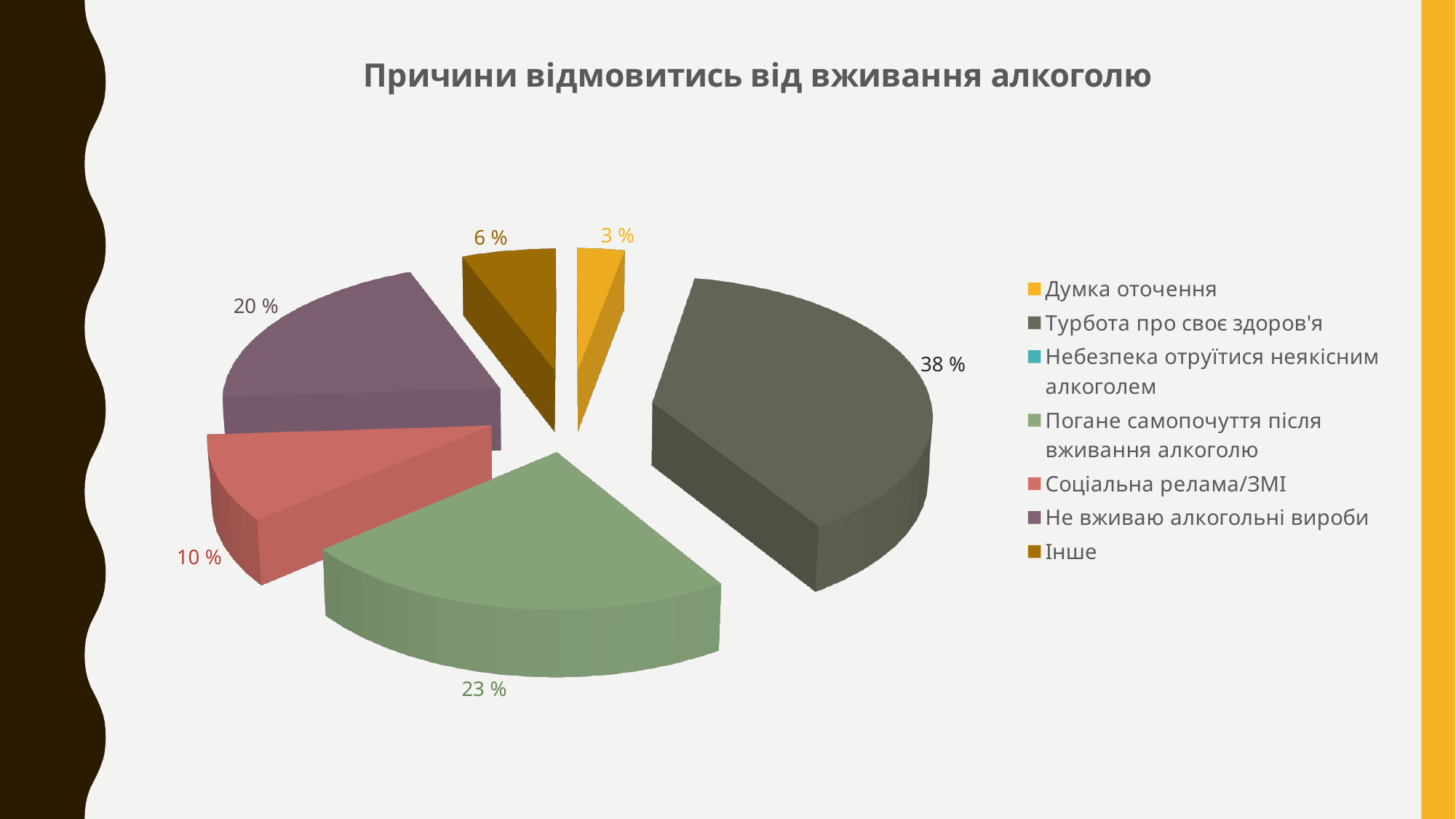
What percentage is shown for "Турбота про своє здоров'я"? 38 % What is the difference in percentage points between "Турбота про своє здоров'я" and "Погане самопочуття після вживання алкоголю"? 15 What percentage is shown for "Думка оточення"? 3 % How many entries does the legend list? 7 Which labelled slice has the smallest share of the pie? Думка оточення Which category has the largest share of the pie? Турбота про своє здоров'я What percentage is shown for "Соціальна релама/ЗМІ"? 10 % What percentage is shown for "Не вживаю алкогольні вироби"? 20 % Which is larger: the share for "Не вживаю алкогольні вироби" or the share for "Соціальна релама/ЗМІ"? Не вживаю алкогольні вироби What is the title of the chart? Причини відмовитись від вживання алкоголю What percentage is shown for "Погане самопочуття після вживання алкоголю"? 23 % What kind of chart is shown on the slide? pie chart